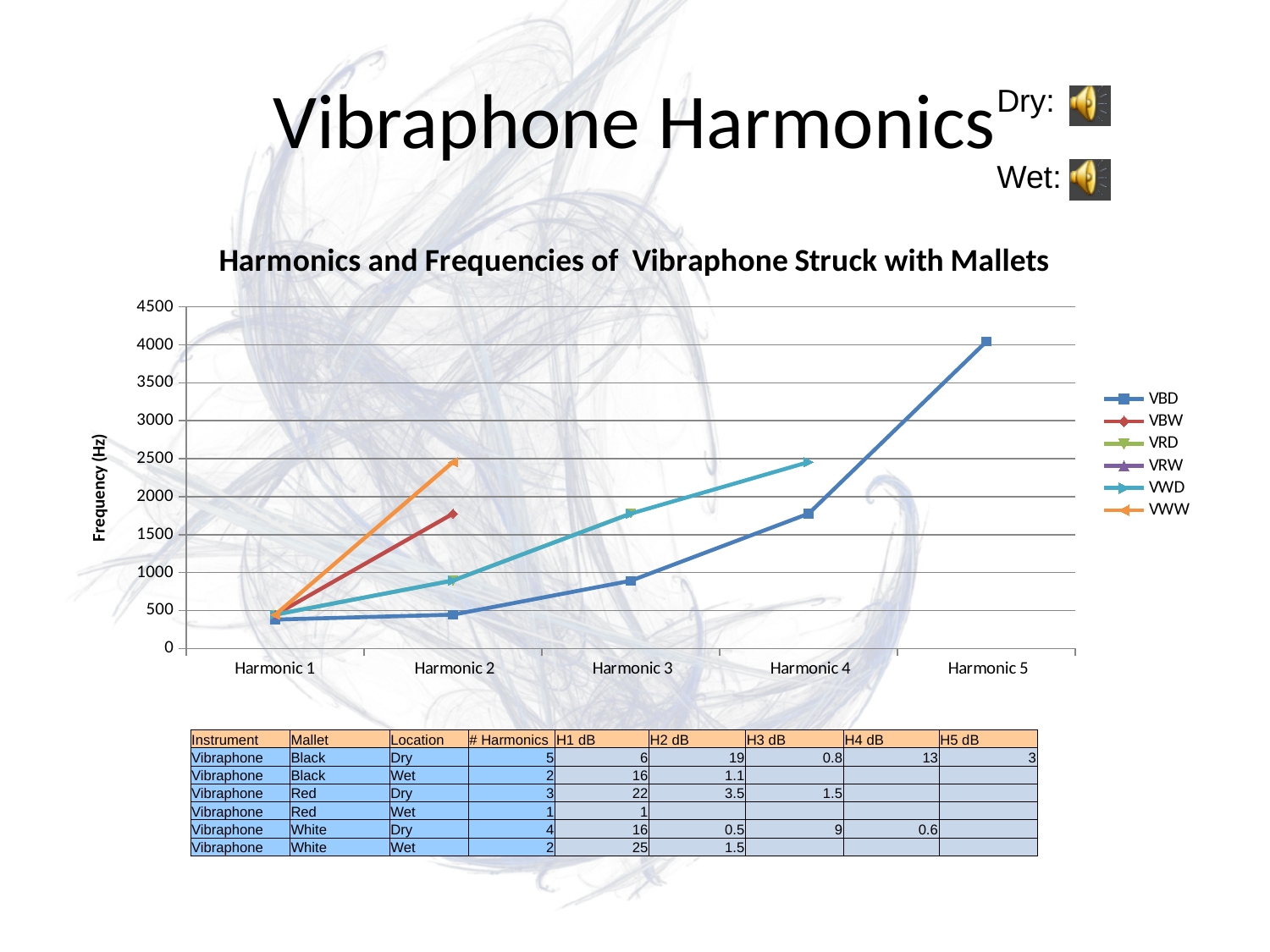
At Harmonic 2, which series has the higher value, VWW or VBW? VWW Is the value for VBD at Harmonic 3 greater or less than 1000? less How many series does the chart legend list? 6 What kind of chart is shown on the slide? line chart At Harmonic 4, which series has the higher value, VWD or VBD? VWD Is the value for VBD at Harmonic 4 greater or less than 2000? less Does the VBD series rise or fall from Harmonic 1 to Harmonic 5? rise What is the label of the vertical axis of the chart? Frequency (Hz) Is the value for VBD at Harmonic 5 greater or less than 3500? greater What is the title of the chart? Harmonics and Frequencies of Vibraphone Struck with Mallets How many harmonic categories are shown on the x axis of the chart? 5